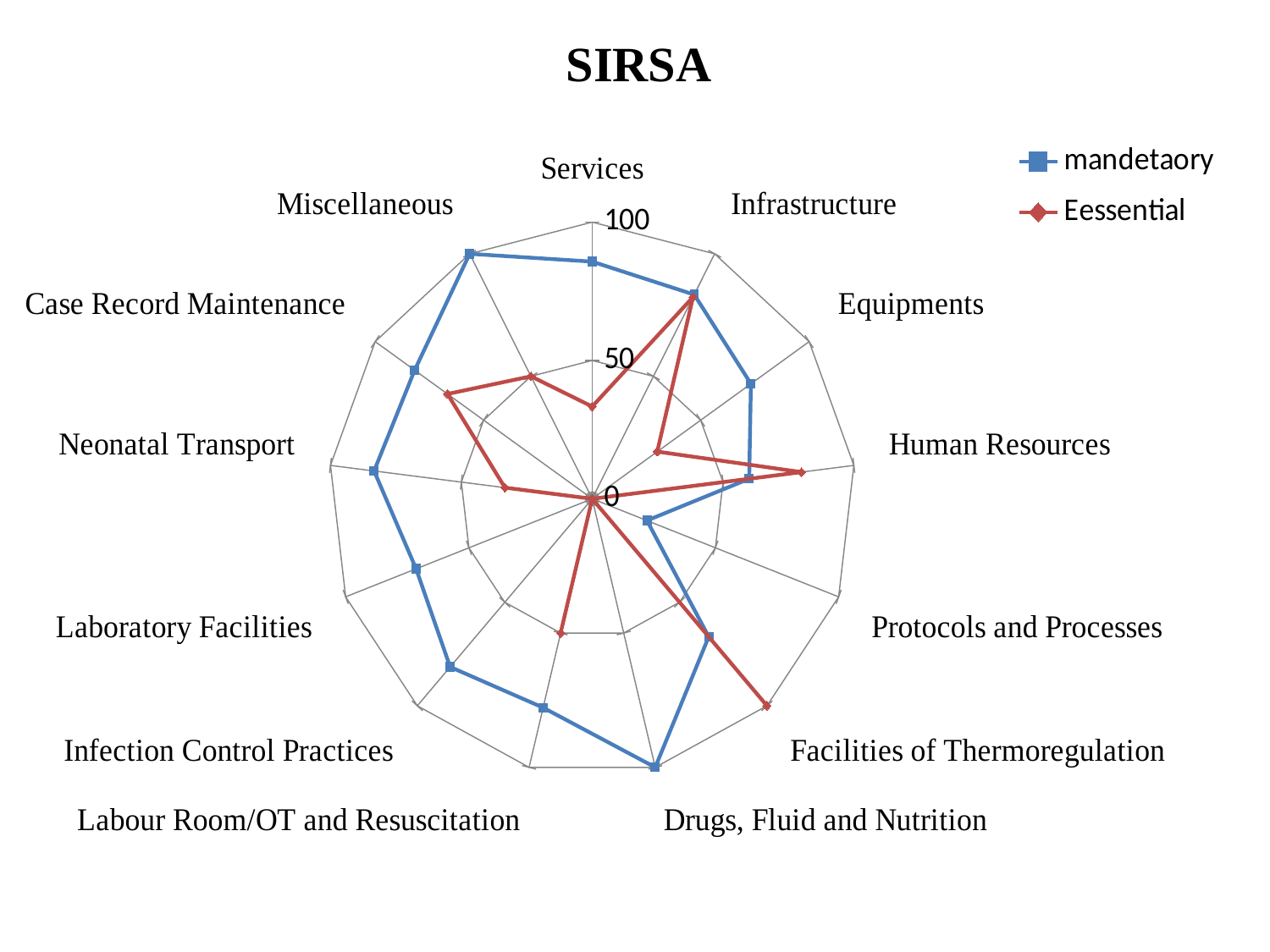
For Human Resources, which series has the larger value, mandetaory or Eessential? Eessential Is the Eessential value for Services greater or less than 50? less Is the Eessential value for Human Resources greater or less than 50? greater How many series does the legend list? 2 Is the Eessential value for Laboratory Facilities greater or less than 50? less What is the title of the chart? SIRSA Which category has the lowest mandetaory value? Protocols and Processes How many categories are plotted around the radar chart? 13 What kind of chart is shown on the slide? Radar chart For Services, which series has the larger value, mandetaory or Eessential? mandetaory